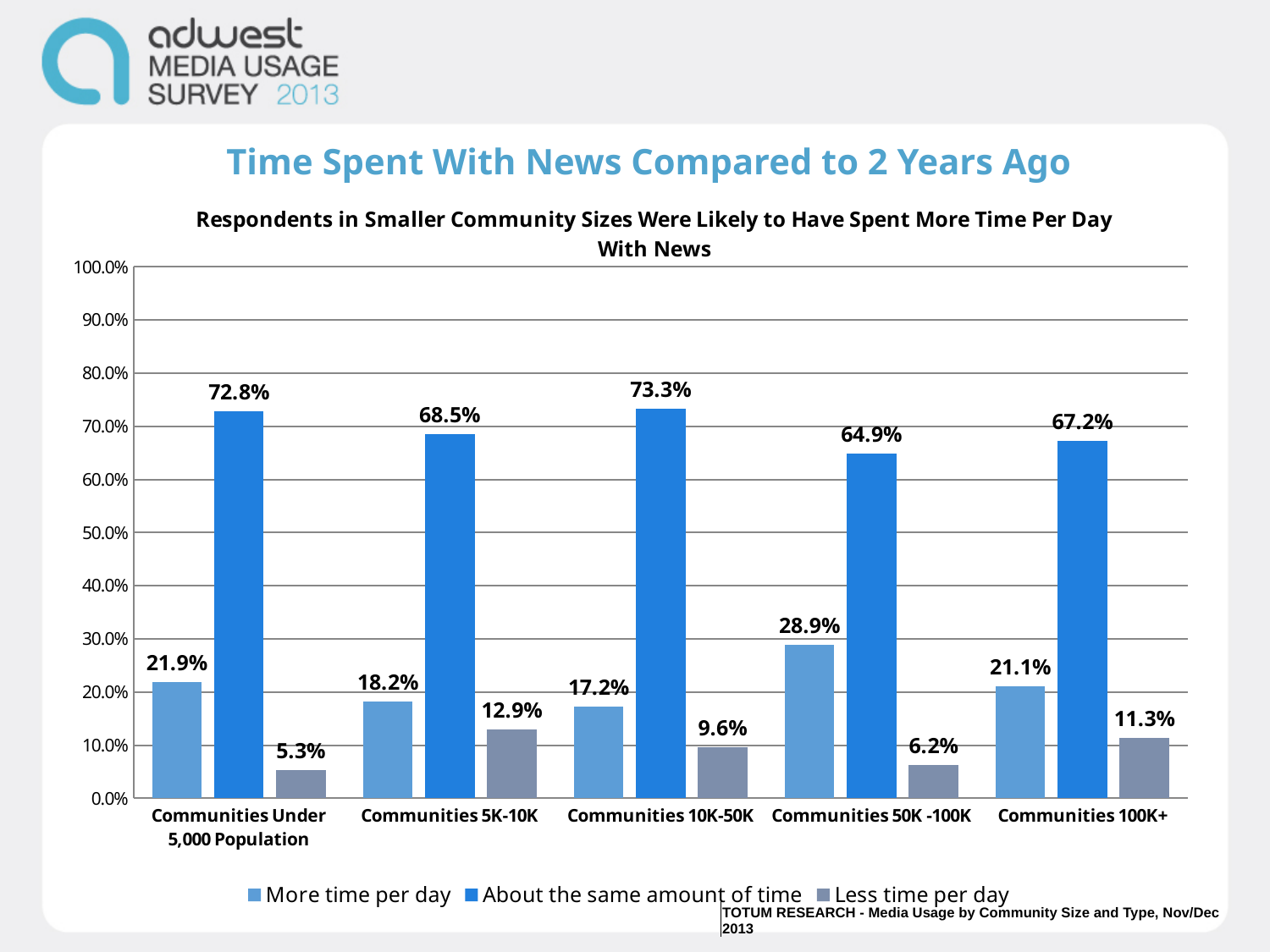
What is the title of the chart? Respondents in Smaller Community Sizes Were Likely to Have Spent More Time Per Day With News Which community size has the highest value for 'About the same amount of time'? Communities 10K-50K How many community size categories are shown on the x axis? 5 What percentage of respondents in Communities 50K-100K spent more time per day with news? 28.9% What kind of chart is shown on the slide? bar chart What is the difference between the 'More time per day' values for Communities 50K-100K and Communities 10K-50K? 11.7% How many series does the legend list? 3 Is the 'About the same amount of time' value for Communities 50K-100K greater or less than 70.0%? less Which community size has the lowest value for 'Less time per day'? Communities Under 5,000 Population What is the value for 'About the same amount of time' in Communities 100K+? 67.2% What is the value for 'Less time per day' in Communities 5K-10K? 12.9% Which is larger: 'More time per day' for Communities Under 5,000 Population or for Communities 100K+? Communities Under 5,000 Population